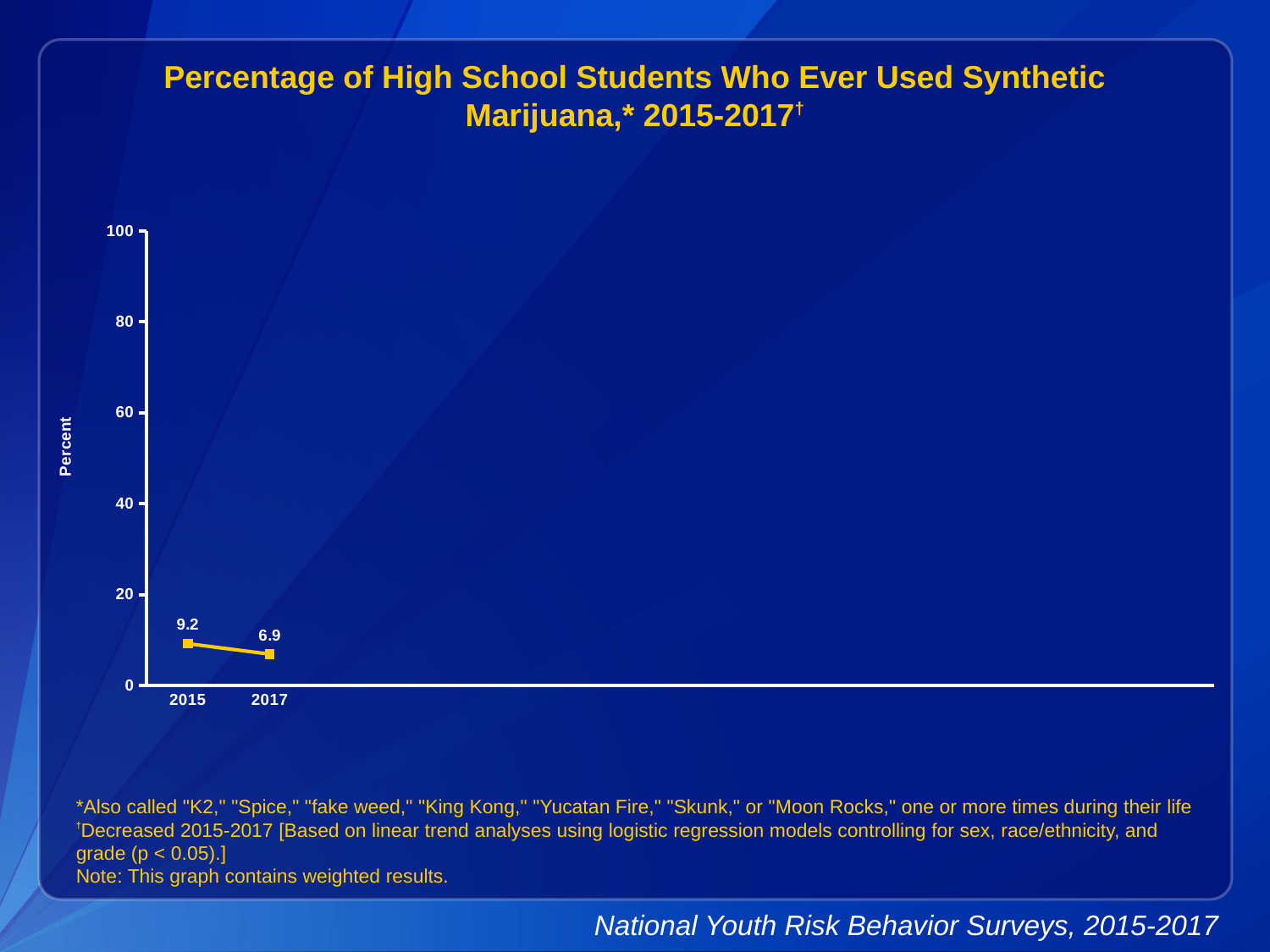
What percentage of high school students had ever used synthetic marijuana in 2017? 6.9 What percentage of high school students had ever used synthetic marijuana in 2015? 9.2 What kind of chart is shown on the slide? line chart Is the value for 2015 larger or smaller than the value for 2017? larger By how many percentage points did the value change from 2015 to 2017? 2.3 Is the value for 2017 greater or less than 20? less What is the label on the vertical axis of the chart? Percent How many years are plotted on the chart? 2 Does the percentage rise or fall from 2015 to 2017? fall What is the maximum value shown on the vertical axis? 100 Which year has the higher percentage of students who ever used synthetic marijuana? 2015 Which year has the lower percentage of students who ever used synthetic marijuana? 2017